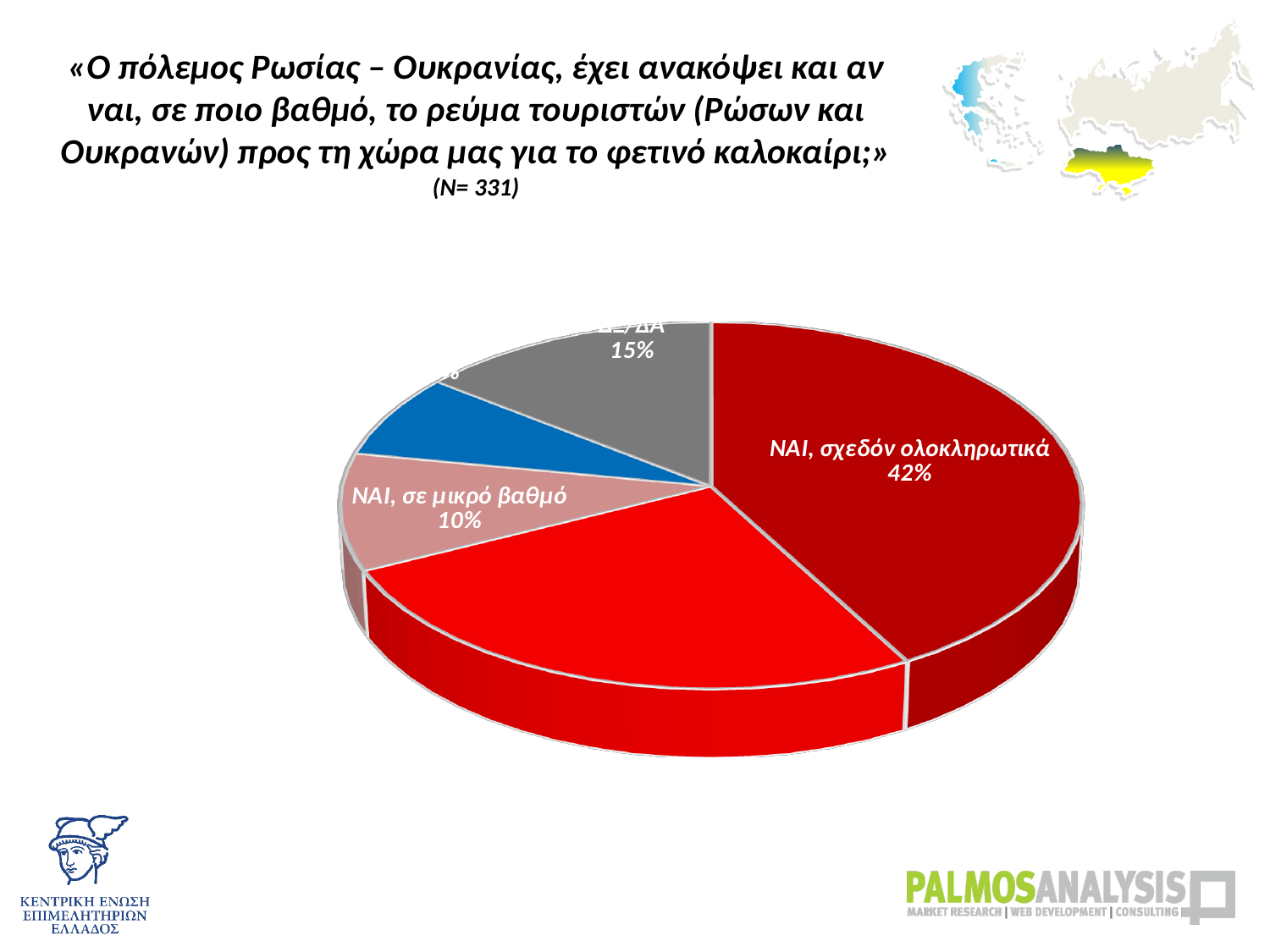
Which is larger: the "ΔΞ/ΔΑ" slice or the "ΝΑΙ, σε μικρό βαθμό" slice? ΔΞ/ΔΑ What colour is the slice labelled "ΝΑΙ, σχεδόν ολοκληρωτικά"? dark red What is the difference in percentage points between the "ΔΞ/ΔΑ" slice and the "ΝΑΙ, σε μικρό βαθμό" slice? 5 percentage points What percentage is shown for the slice labelled "ΝΑΙ, σε μικρό βαθμό"? 10% Which slice of the pie chart is the largest? ΝΑΙ, σχεδόν ολοκληρωτικά What percentage is shown for the slice labelled "ΔΞ/ΔΑ"? 15% What kind of chart is shown on the slide? pie chart What sample size (N) is stated under the question title on the slide? N= 331 What is the difference in percentage points between the "ΝΑΙ, σχεδόν ολοκληρωτικά" slice and the "ΔΞ/ΔΑ" slice? 27 percentage points How many slices does the pie chart have? 5 What percentage is shown for the slice labelled "ΝΑΙ, σχεδόν ολοκληρωτικά"? 42% Which is larger: the "ΝΑΙ, σχεδόν ολοκληρωτικά" slice or the "ΔΞ/ΔΑ" slice? ΝΑΙ, σχεδόν ολοκληρωτικά